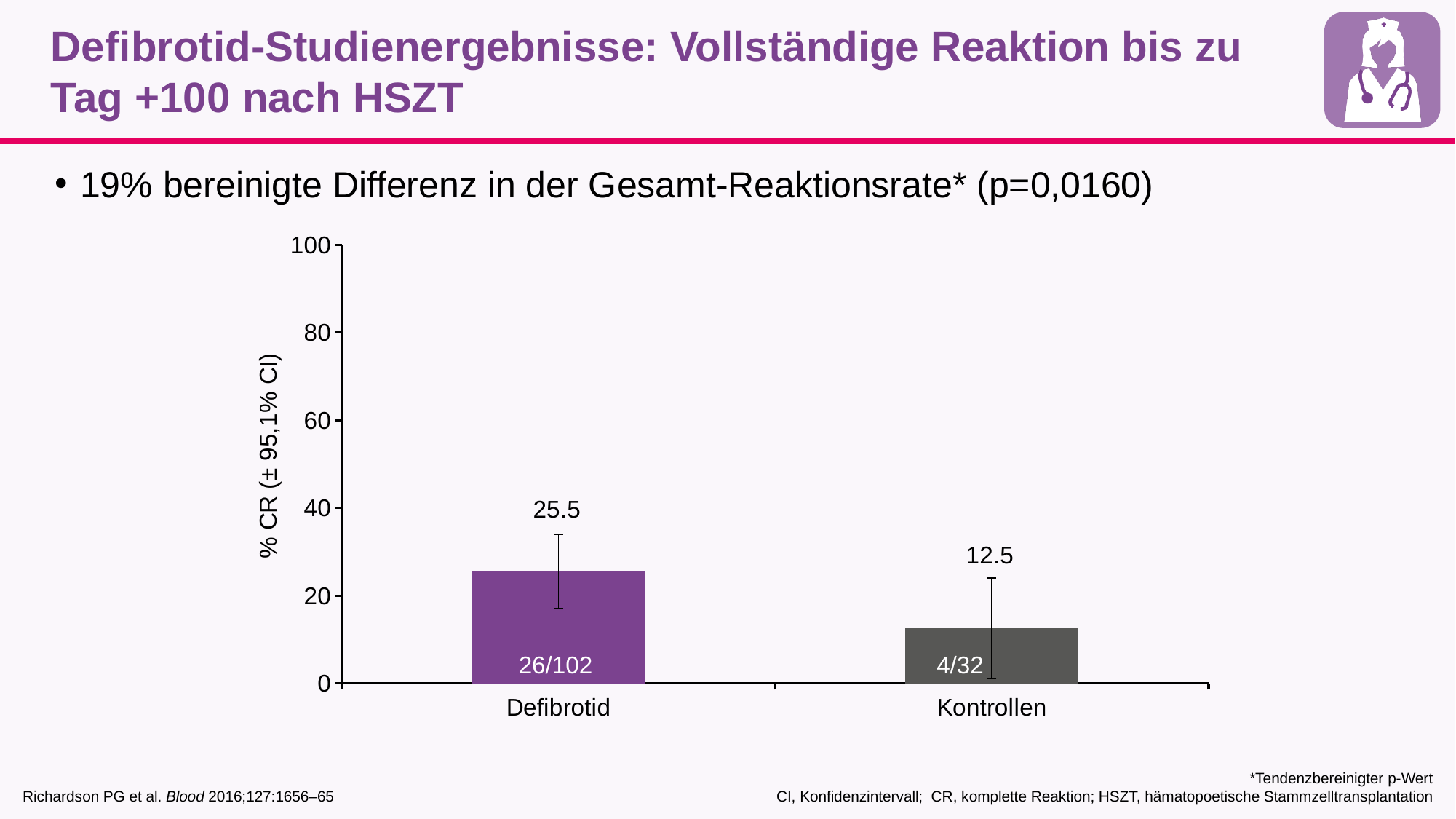
Is the % CR for Kontrollen greater or less than 20? less What kind of chart is shown on the slide? Bar chart What fraction is printed inside the Kontrollen bar? 4/32 What fraction is printed inside the Defibrotid bar? 26/102 What is the label of the y axis? % CR (± 95,1% CI) Which category has the higher % CR? Defibrotid Is the % CR for Defibrotid greater or less than 20? greater What is the % CR value for Kontrollen? 12.5 How many categories are shown on the x axis? 2 What is the difference in % CR between Defibrotid and Kontrollen? 13 What is the % CR value for Defibrotid? 25.5 Which category has the lower % CR? Kontrollen